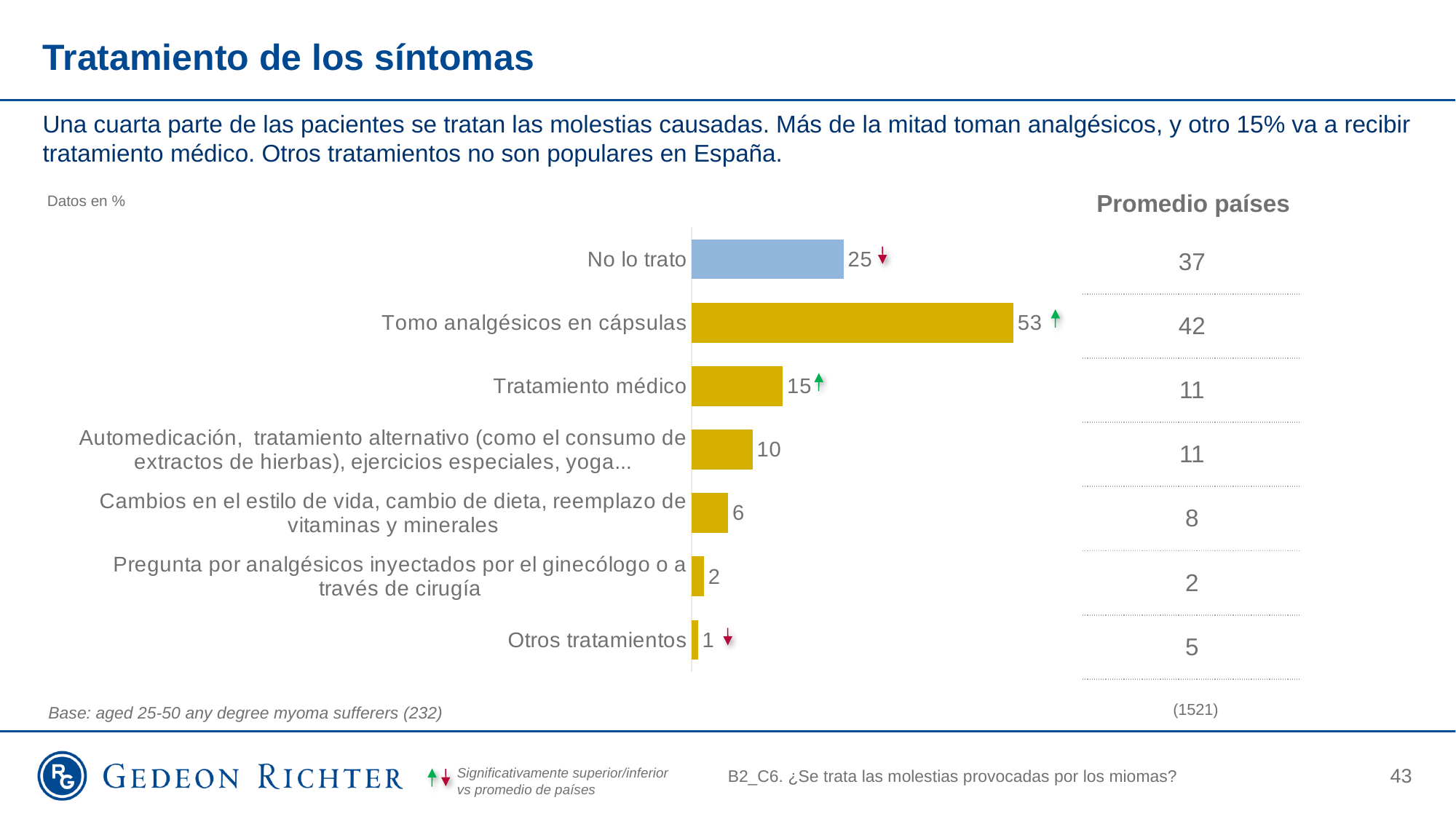
What is the value for "Tratamiento médico"? 15 Which is larger, the value for "Tratamiento médico" or the value for "Cambios en el estilo de vida, cambio de dieta, reemplazo de vitaminas y minerales"? Tratamiento médico What is the value for "Otros tratamientos"? 1 What is the difference between the values for "Tomo analgésicos en cápsulas" and "No lo trato"? 28 What kind of chart is shown on the slide? Bar chart Which category has the highest value? Tomo analgésicos en cápsulas Which category has the lowest value? Otros tratamientos What is the value for "No lo trato"? 25 What is the "Promedio países" value shown next to "No lo trato"? 37 What is the value for "Tomo analgésicos en cápsulas"? 53 Which bar is shown in a different colour (blue) from the others? No lo trato How many categories are shown in the chart? 7